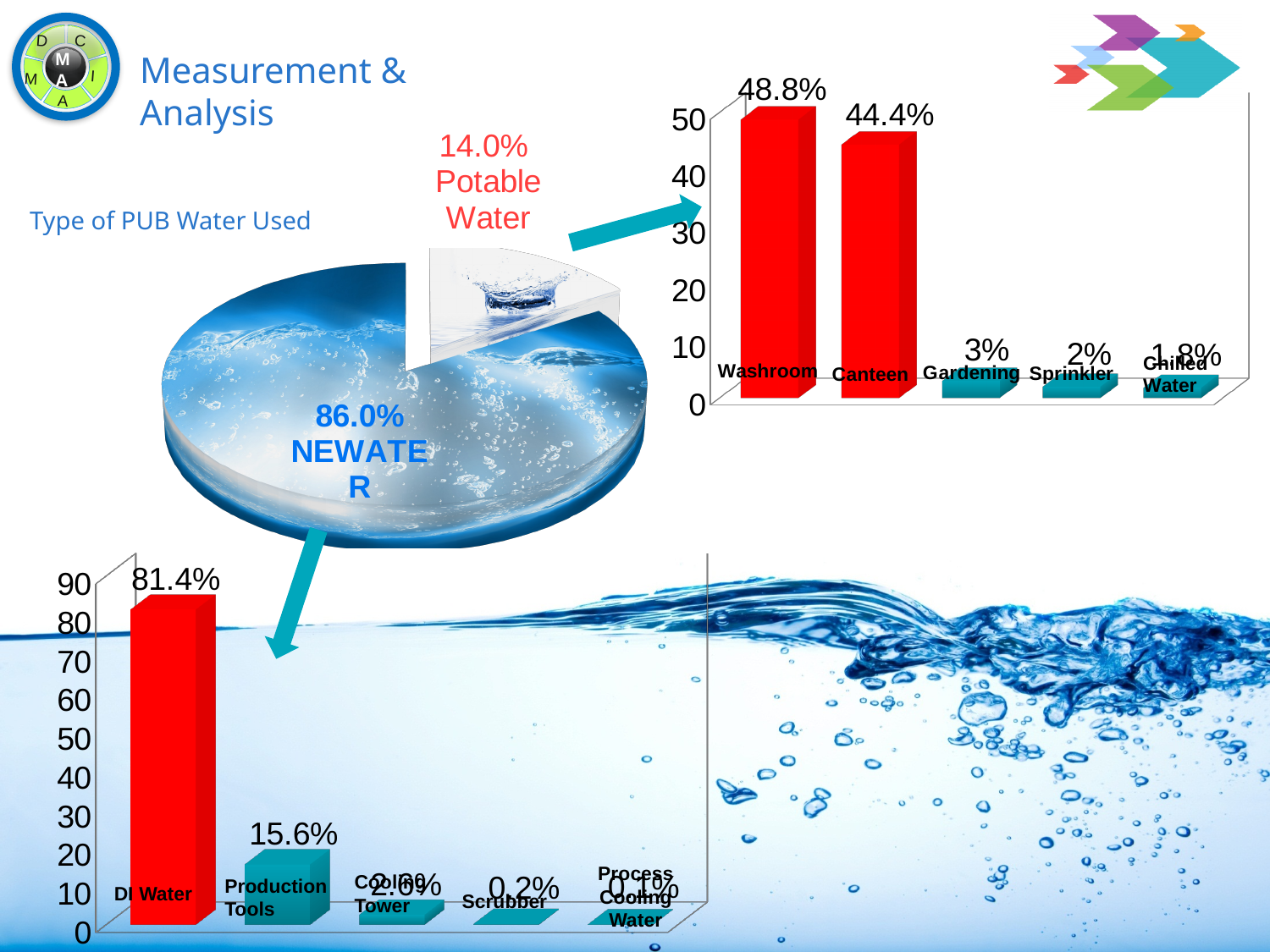
In the top-right bar chart, what is the value for Washroom? 48.8% In the top-right bar chart, how many categories are shown? 5 In the top-right bar chart, which category has the lowest value? Chilled Water In the top-right bar chart, what is the difference between Washroom and Canteen? 4.4% In the pie chart 'Type of PUB Water Used', what share is Potable Water? 14.0% What kind of chart is the 'Type of PUB Water Used' chart? pie chart In the bottom-left bar chart, which is larger, Cooling Tower or Scrubber? Cooling Tower In the bottom-left bar chart, which category has the highest value? DI Water In the pie chart 'Type of PUB Water Used', what share is NEWATER? 86.0% In the bottom-left bar chart, what is the value for DI Water? 81.4% In the top-right bar chart, what is the value for Canteen? 44.4% In the bottom-left bar chart, what is the value for Production Tools? 15.6%